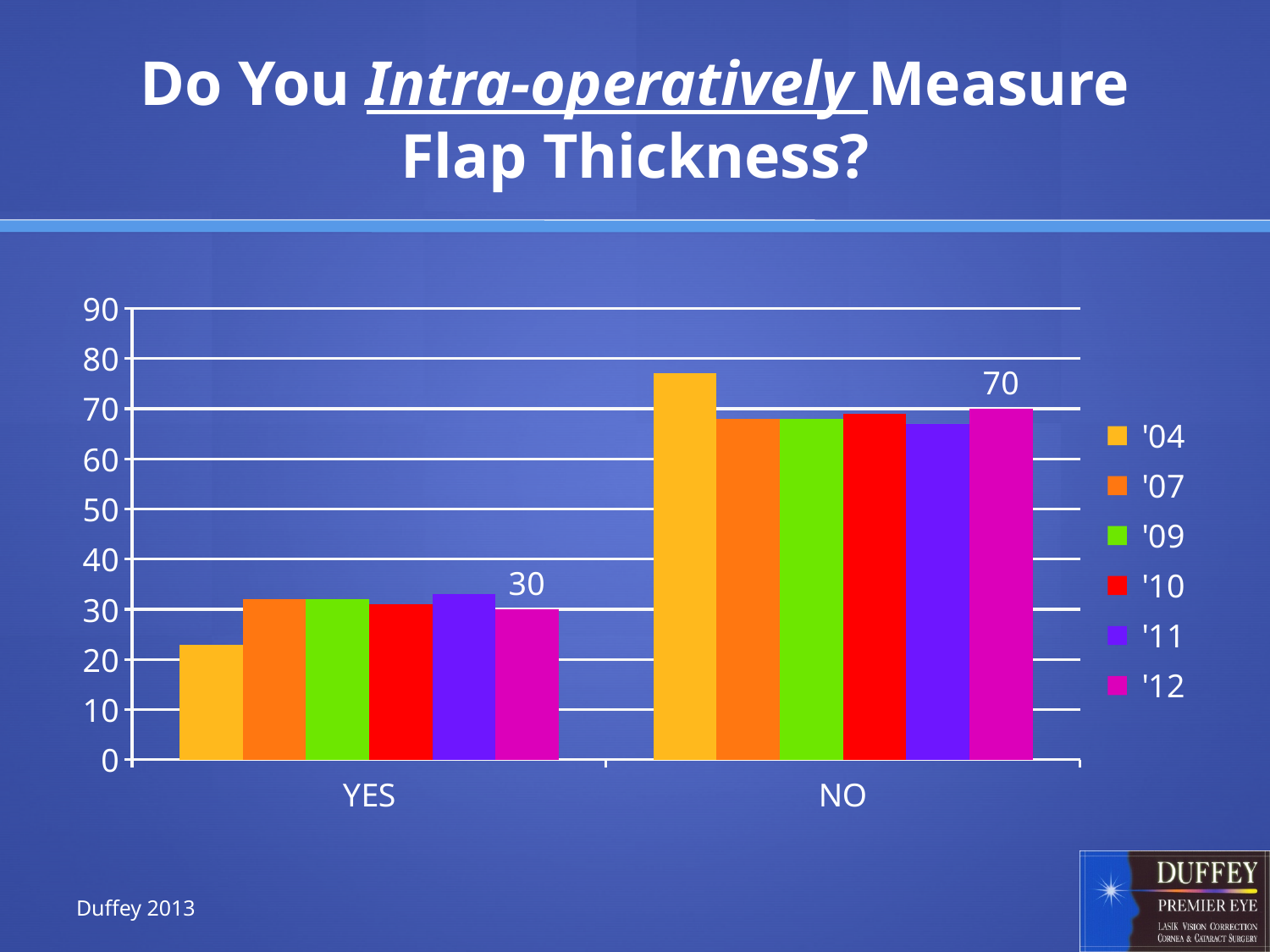
Within the NO category, which series has the highest bar? '04 What is the value for '12 in the YES category? 30 How many categories are shown on the x axis? 2 Within the YES category, which series has the lowest bar? '04 How many series does the legend list? 6 What is the value for '12 in the NO category? 70 For the '12 series, which category has the larger value, YES or NO? NO What is the title of the slide? Do You Intra-operatively Measure Flap Thickness? Is the value for '04 in the YES category greater or less than 30? less What kind of chart is shown on the slide? bar chart What is the difference between the '12 values for NO and YES? 40 Is the value for '04 in the NO category greater or less than 70? greater